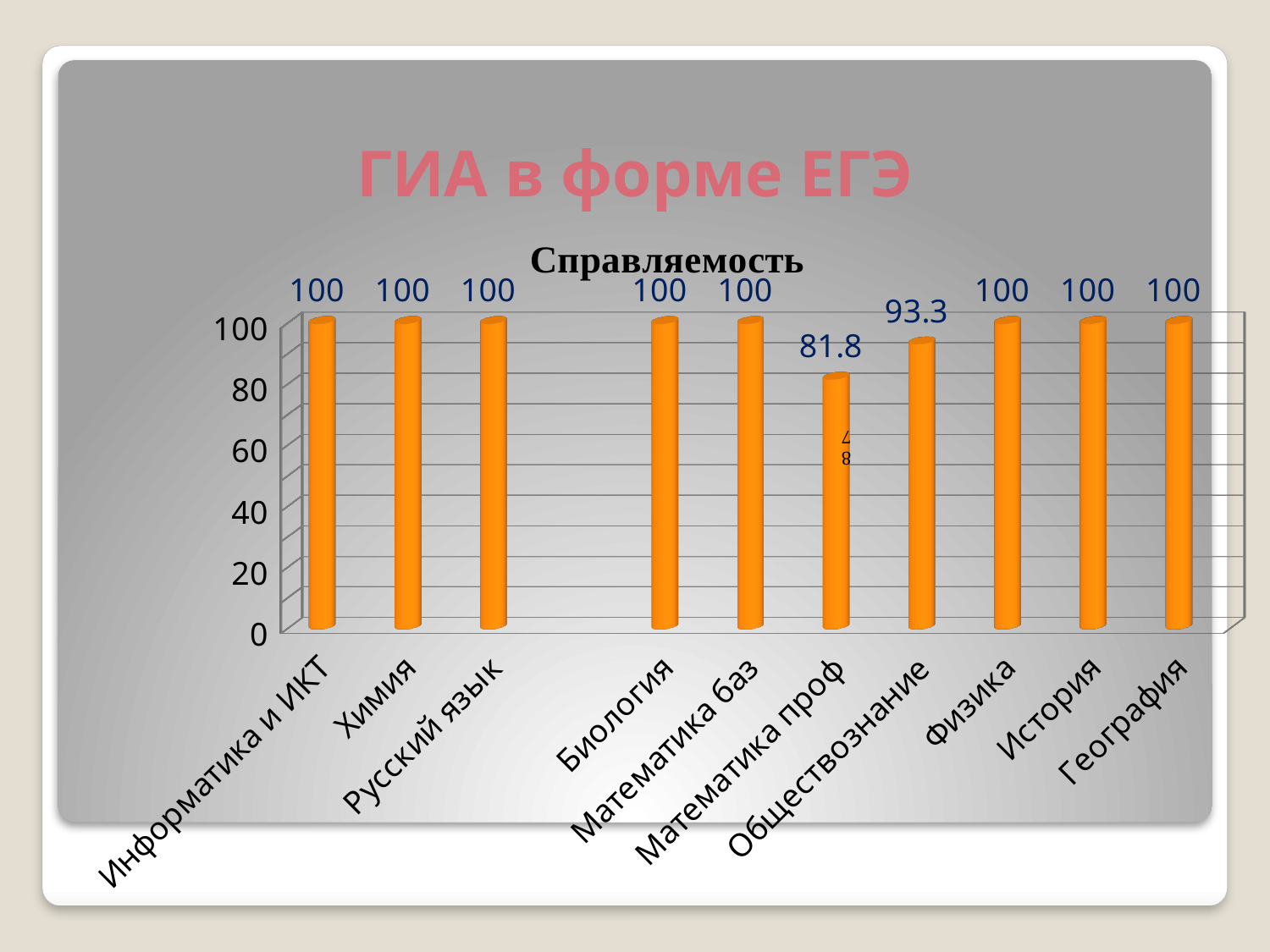
What kind of chart is shown on the slide? bar chart What is the difference between the values for Обществознание and Математика проф? 11.5 What is the difference between the values for Биология and Математика проф? 18.2 What is the title of the chart? Справляемость What is the value for Обществознание? 93.3 What is the value for Химия? 100 How many bars are plotted in the chart? 10 What is the value for Математика проф? 81.8 Which category has the lowest value? Математика проф Which is larger, the value for Обществознание or the value for Математика проф? Обществознание Is the value for Математика проф greater or less than 80? greater What is the value for Физика? 100